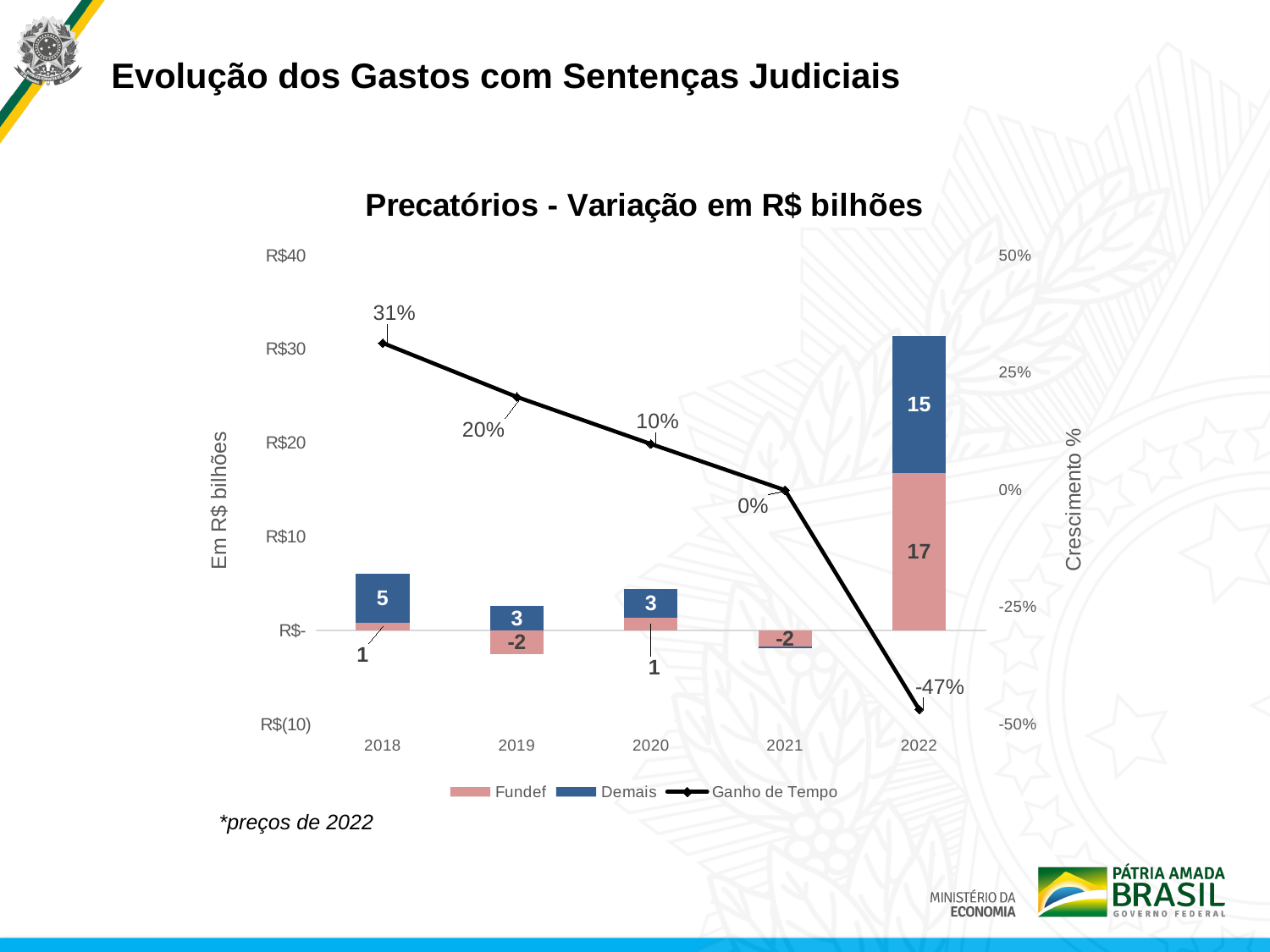
What is the difference between the Fundef and Demais values in 2022? 2 How many years are shown on the x axis? 5 In which year is Ganho de Tempo highest? 2018 In which year is Ganho de Tempo lowest? 2022 Does the Ganho de Tempo line rise or fall from 2018 to 2022? fall What is the value of Demais in 2022? 15 What is the Ganho de Tempo value for 2018? 31% What is the Ganho de Tempo value for 2022? -47% Which is larger, the Demais value in 2018 or in 2019? 2018 What is the value of Fundef in 2022? 17 What is the total of the stacked bar for 2022 (Fundef plus Demais)? 32 How many series does the legend list? 3